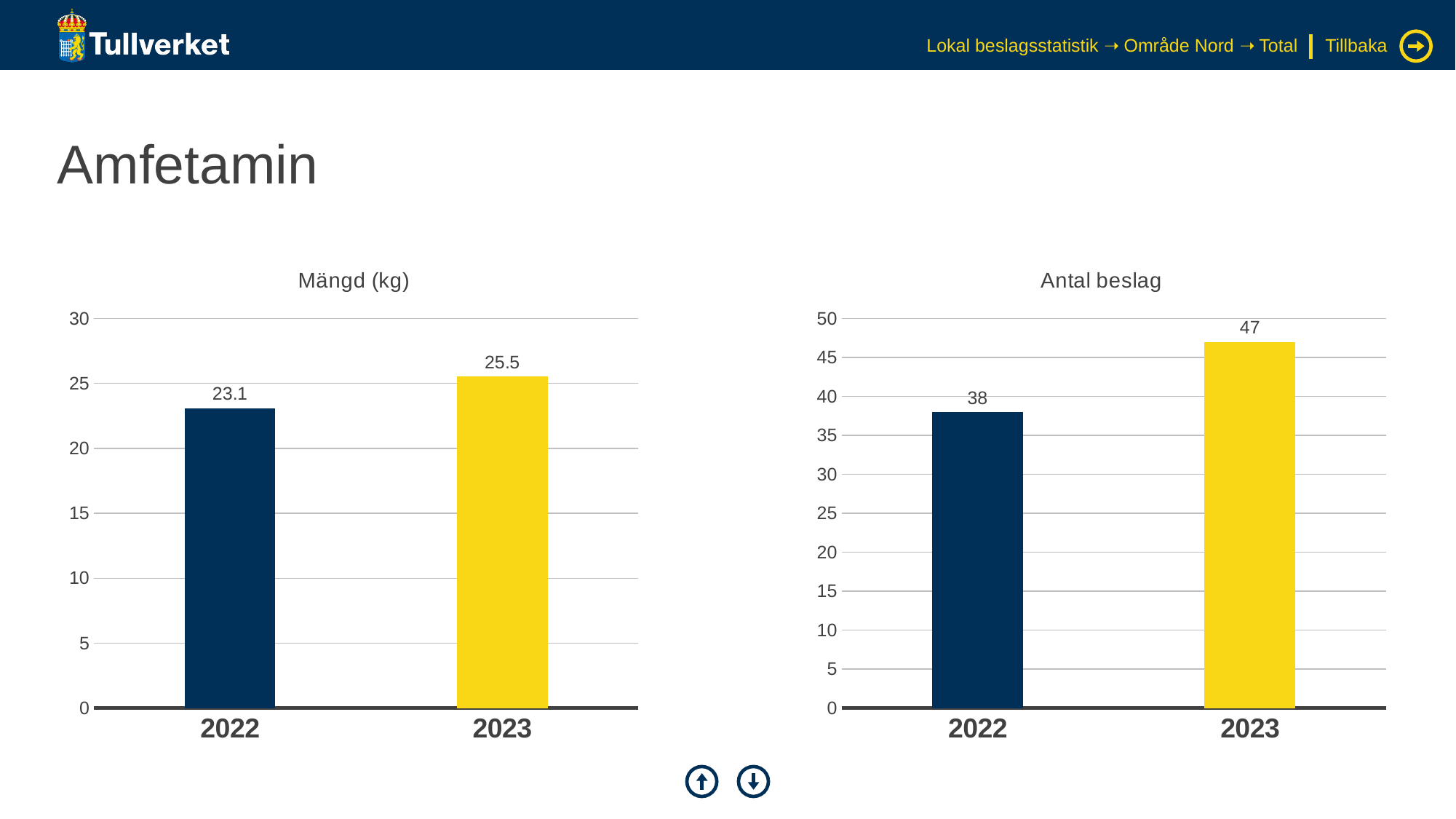
In the 'Antal beslag' chart, do the values rise or fall from 2022 to 2023? rise In the 'Antal beslag' chart, what is the value for 2023? 47 In the 'Antal beslag' chart, which year has the lower value? 2022 How many categories are shown on the x axis of the 'Mängd (kg)' chart? 2 In the 'Antal beslag' chart, what is the value for 2022? 38 In the 'Mängd (kg)' chart, what is the value for 2023? 25.5 What kind of chart is the 'Antal beslag' chart? bar chart In the 'Mängd (kg)' chart, what is the difference between the 2023 and 2022 values? 2.4 In the 'Antal beslag' chart, is the value for 2022 greater or less than 40? less In the 'Mängd (kg)' chart, what is the value for 2022? 23.1 In the 'Antal beslag' chart, what is the difference between the 2023 and 2022 values? 9 In the 'Mängd (kg)' chart, which year has the higher value? 2023